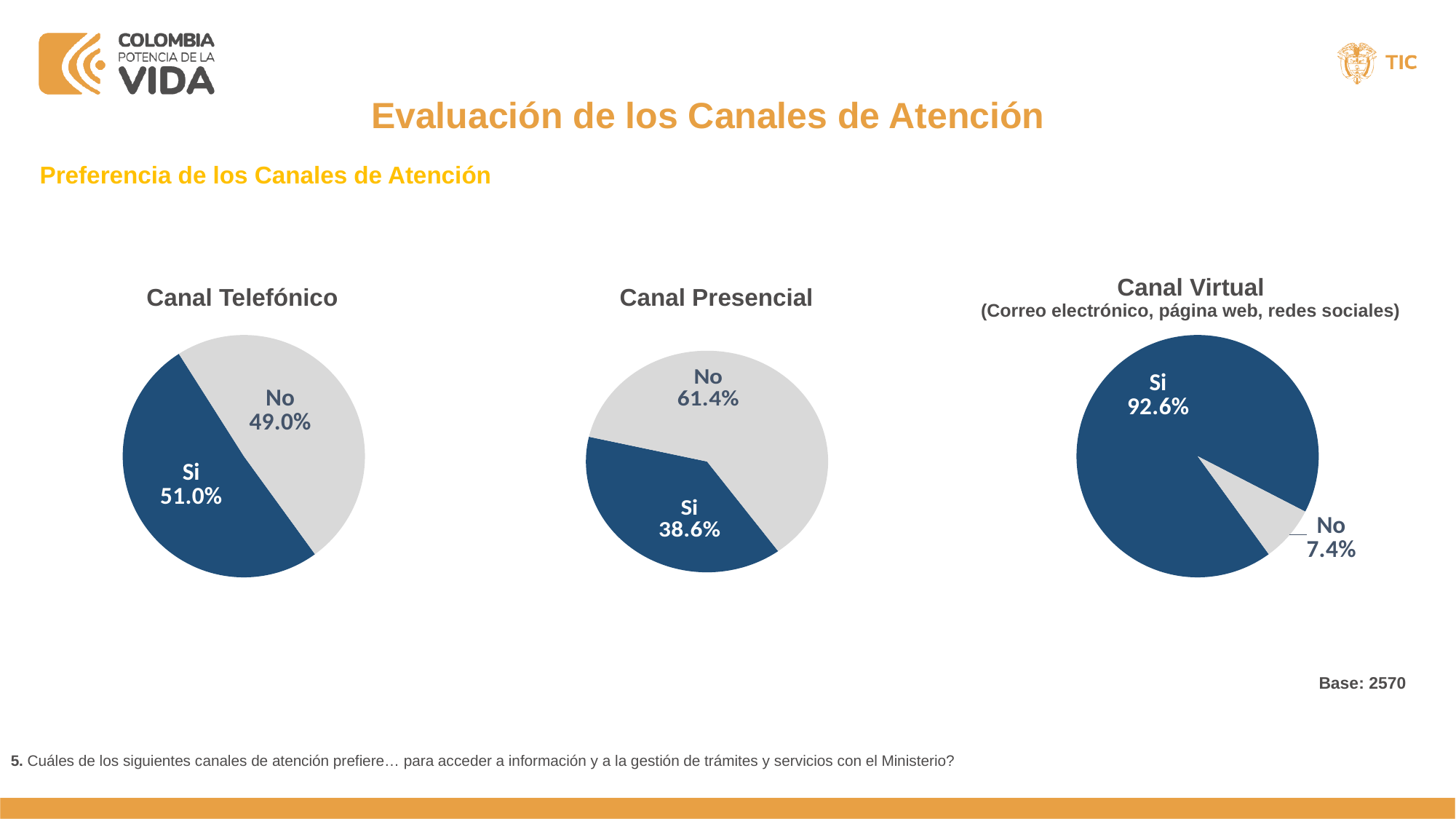
In the Canal Virtual chart, which slice is the smallest? No In the Canal Presencial chart, what is the value for Si? 38.6% In the Canal Presencial chart, what is the difference between the No and Si values? 22.8% In the Canal Virtual chart, what is the value for Si? 92.6% In the Canal Virtual chart, what is the value for No? 7.4% In the Canal Telefónico chart, what is the value for No? 49.0% What kind of chart is the Canal Telefónico chart? Pie chart In the Canal Presencial chart, which slice is the largest? No In the Canal Virtual chart, what is the difference between the Si and No values? 85.2% In the Canal Presencial chart, what is the value for No? 61.4% How many pie charts are shown on the slide? 3 In the Canal Telefónico chart, what is the value for Si? 51.0%